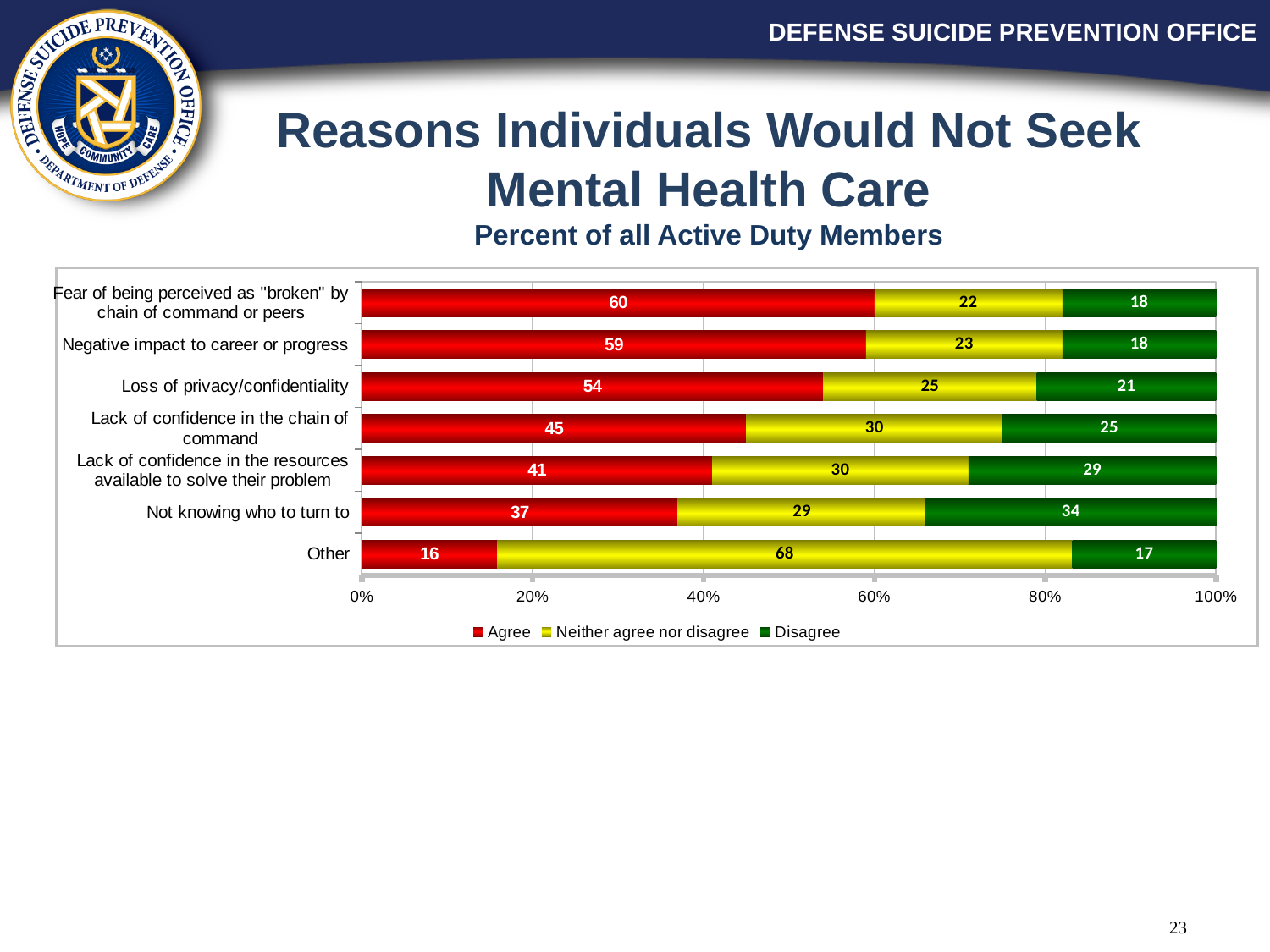
What is the total of the stacked bar for "Lack of confidence in the resources available to solve their problem"? 100 What is the Neither agree nor disagree value for "Other"? 68 What is the Disagree value for "Not knowing who to turn to"? 34 What is the Agree value for "Fear of being perceived as "broken" by chain of command or peers"? 60 Which category has the highest Agree value? Fear of being perceived as "broken" by chain of command or peers Which colour represents the Disagree series in the legend? Green What is the difference between the Agree values for "Loss of privacy/confidentiality" and "Not knowing who to turn to"? 17 How many categories are shown on the chart? 7 Which category has the lowest Agree value? Other What kind of chart is shown on the slide? Stacked bar chart How many series does the legend list? 3 Which is larger: the Disagree value for "Lack of confidence in the chain of command" or the Disagree value for "Loss of privacy/confidentiality"? Lack of confidence in the chain of command